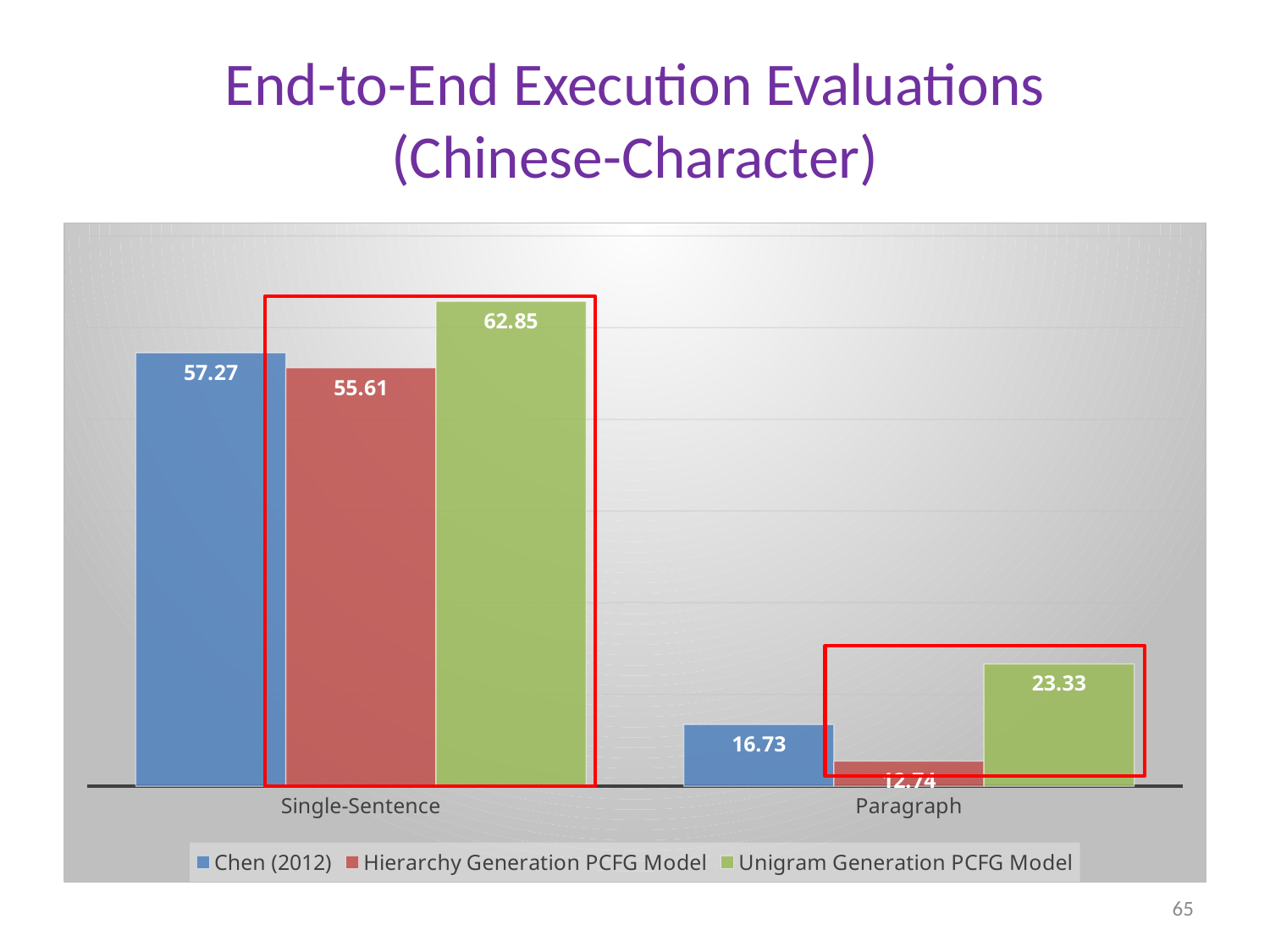
What is the value for Chen (2012) in the Paragraph category? 16.73 What is the value for the Unigram Generation PCFG Model in the Paragraph category? 23.33 Which series has the highest value in the Single-Sentence category? Unigram Generation PCFG Model What is the difference between the Unigram Generation PCFG Model and Chen (2012) values in the Single-Sentence category? 5.58 Which series has the lowest value in the Paragraph category? Hierarchy Generation PCFG Model What is the value for the Hierarchy Generation PCFG Model in the Single-Sentence category? 55.61 What kind of chart is shown on the slide? bar chart How many series does the legend list? 3 What is the value for the Unigram Generation PCFG Model in the Single-Sentence category? 62.85 How many categories are shown on the x axis? 2 What is the value for Chen (2012) in the Single-Sentence category? 57.27 Which is larger in the Paragraph category: Chen (2012) or the Unigram Generation PCFG Model? Unigram Generation PCFG Model